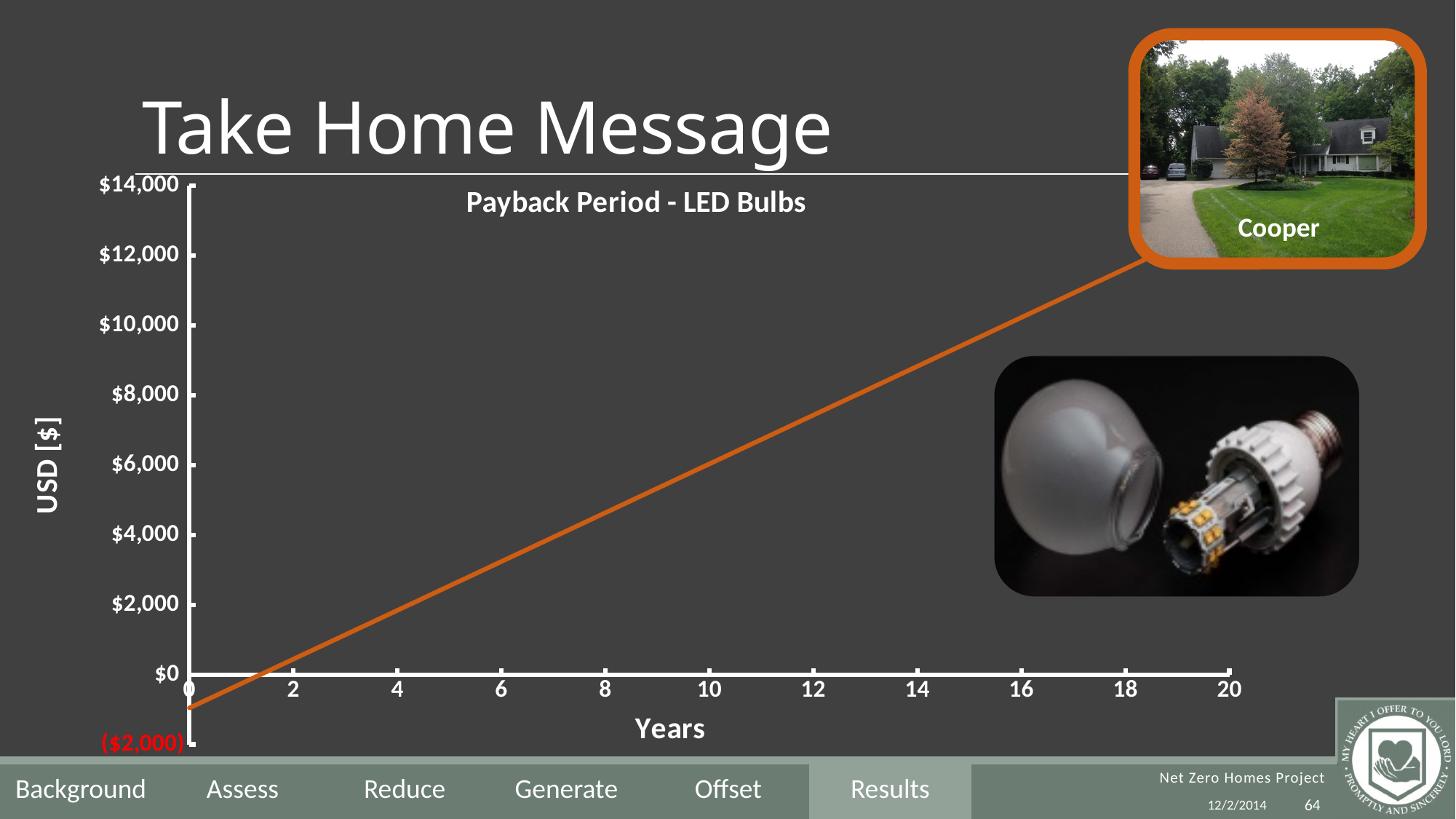
What is the title of the chart? Payback Period - LED Bulbs How many tick labels are shown on the x axis (Years)? 11 How many lines are plotted on the chart? 1 Is the value of the line at year 16 greater or less than $8,000? greater Is the value of the line at year 2 greater or less than $0? greater Does the plotted line rise or fall as the years increase? rise Is the value of the line at year 10 greater or less than $8,000? less What is the label of the y axis? USD [$] What kind of chart is shown on the slide? line chart